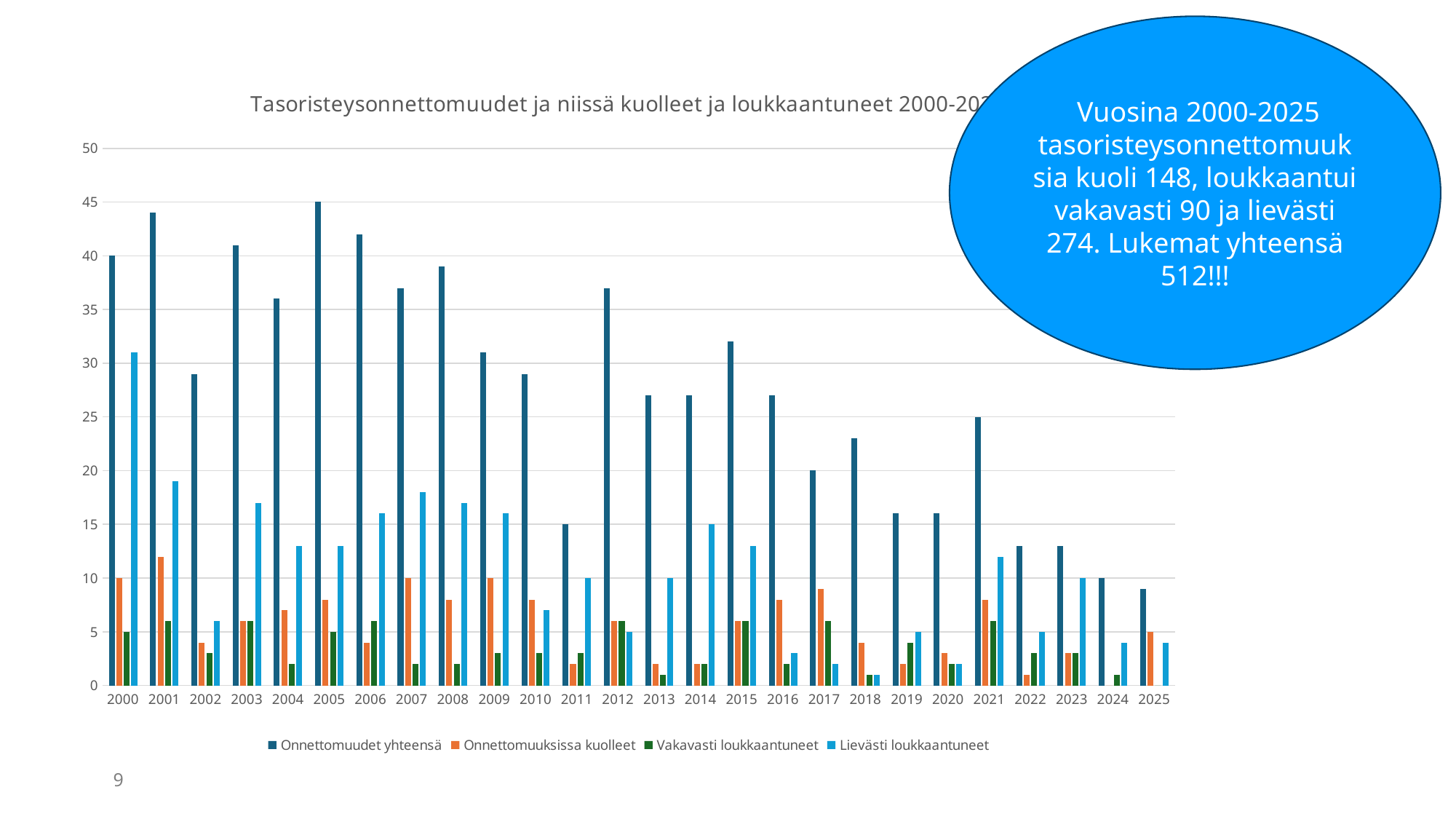
Do the values of Onnettomuudet yhteensä generally rise or fall from 2000 to 2025? fall What is the value of Onnettomuudet yhteensä for 2017? 20 Is the value of Onnettomuuksissa kuolleet for 2001 greater or less than 10? greater What kind of chart is shown on the slide? bar chart Which year has the higher value of Lievästi loukkaantuneet, 2000 or 2001? 2000 How many years are shown on the x axis? 26 What is the value of Onnettomuudet yhteensä for 2005? 45 Is the value of Onnettomuudet yhteensä for 2018 greater or less than 25? less Is the value of Onnettomuudet yhteensä for 2001 greater or less than 40? greater Which series is shown in orange in the legend? Onnettomuuksissa kuolleet What is the value of Onnettomuudet yhteensä for 2024? 10 How many series does the legend list? 4